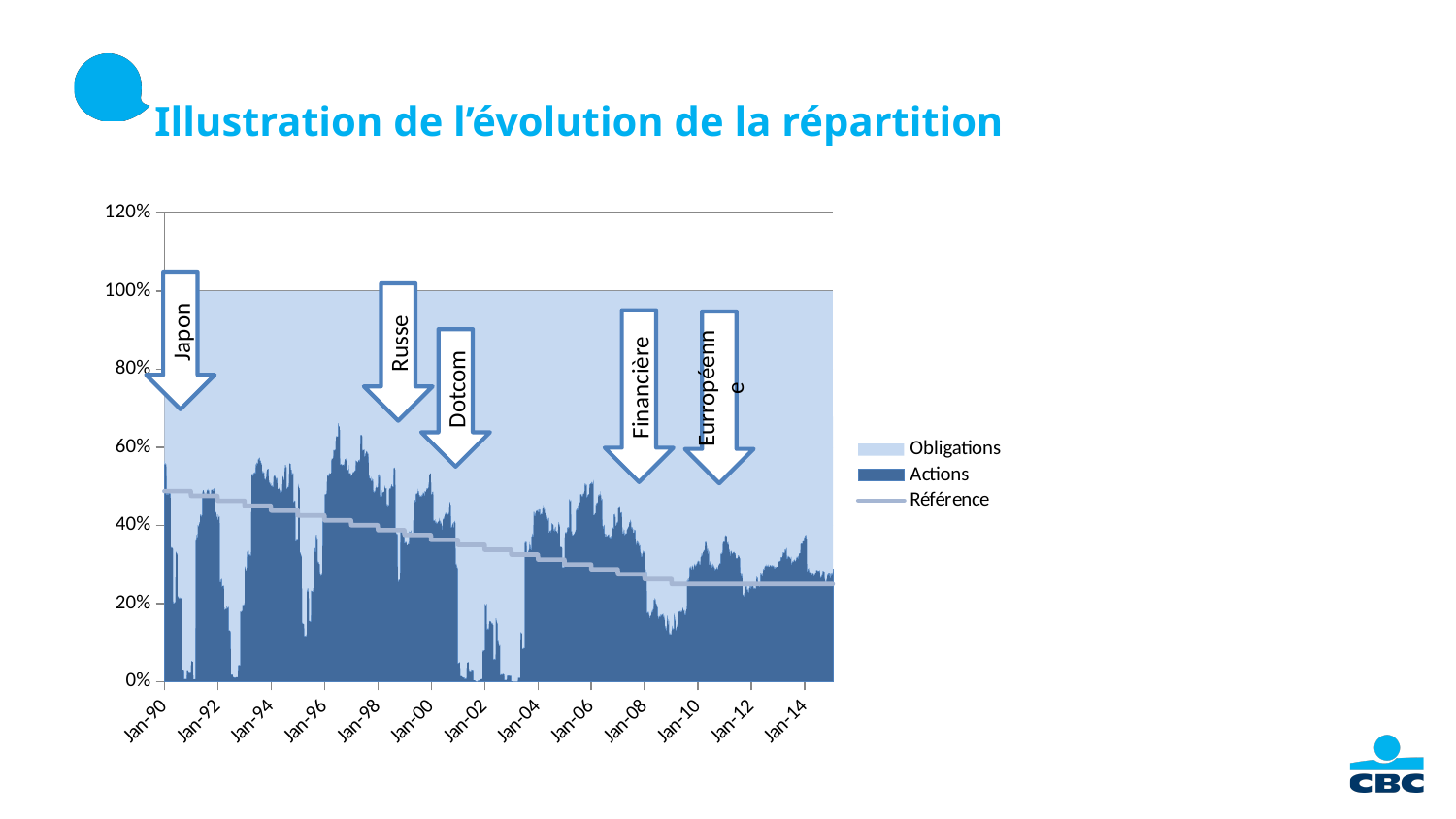
Is the Référence value at Jan-14 greater or less than 40%? less Is the Actions share around Jan-09 greater or less than 40%? less How many year labels are shown on the x axis? 13 Which series is larger at Jan-02, Obligations or Actions? Obligations Which series are listed in the legend? Obligations, Actions, Référence Is the Actions share around Jan-02 greater or less than 20%? less What kind of chart is shown on the slide? area chart How many series does the legend list? 3 What is the highest value shown on the y axis? 120% Does the Référence line rise or fall from Jan-90 to Jan-14? fall